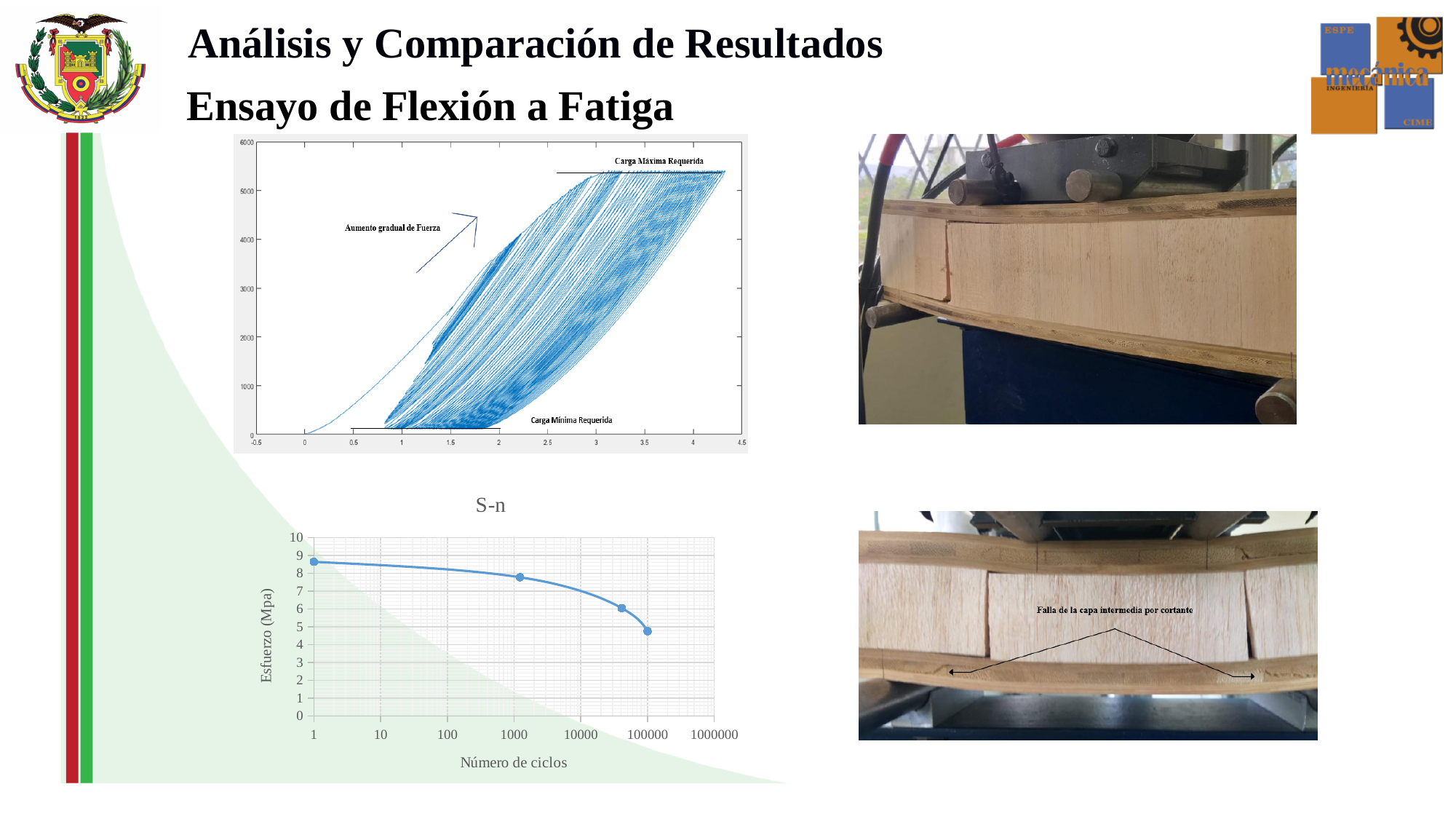
What is the y-axis label of the S-n chart? Esfuerzo (Mpa) On the top chart, is the level labelled 'Carga Mínima Requerida' greater or less than 1000? less On the S-n chart, which point has the highest stress, the leftmost or the rightmost? leftmost What is the title of the bottom chart on the slide? S-n On the top chart, is the plateau labelled 'Carga Máxima Requerida' greater or less than 5000? greater On the S-n chart, which is larger: the stress at 1 cycle or the stress at the rightmost point? the stress at 1 cycle How many data points are plotted on the S-n chart? 4 What kind of chart is the S-n chart? line chart On the S-n chart, is the stress value of the rightmost point greater or less than 6 MPa? less On the S-n chart, do the stress values rise or fall as the number of cycles increases? fall